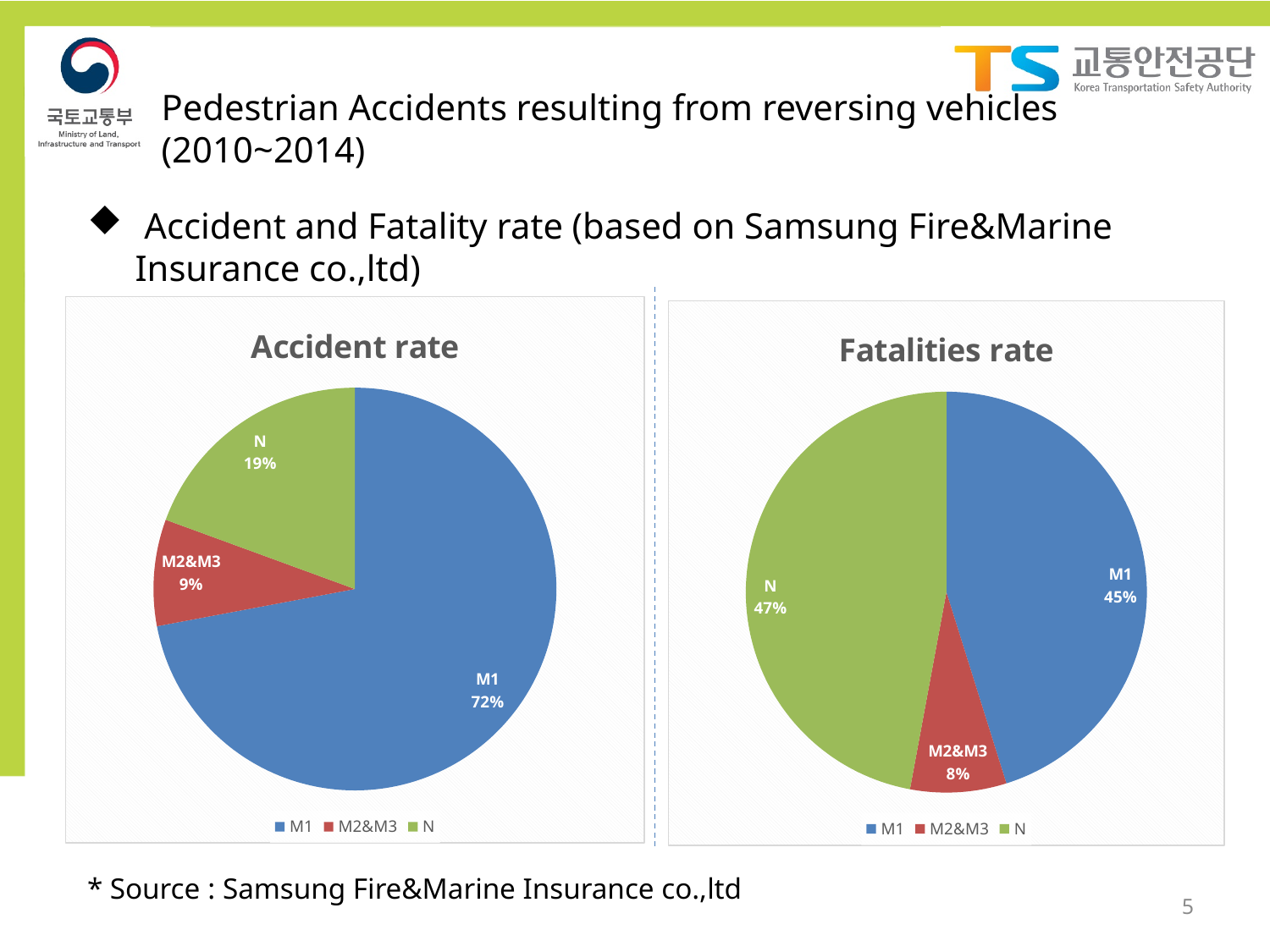
In the Fatalities rate chart, what is the share for M2&M3? 8% What kind of chart is the Accident rate chart? Pie chart In the Accident rate chart, which category has the largest slice? M1 In the Fatalities rate chart, which is larger, the share for M1 or the share for M2&M3? M1 In the Fatalities rate chart, what is the share for N? 47% In the Accident rate chart, what colour is the M2&M3 slice? Red In the Fatalities rate chart, which category has the largest slice? N In the Fatalities rate chart, which category has the smallest slice? M2&M3 In the Accident rate chart, what is the share for N? 19% In the Accident rate chart, what is the difference between the M1 share and the N share? 53% How many categories does the Fatalities rate chart show? 3 In the Accident rate chart, what is the share for M1? 72%